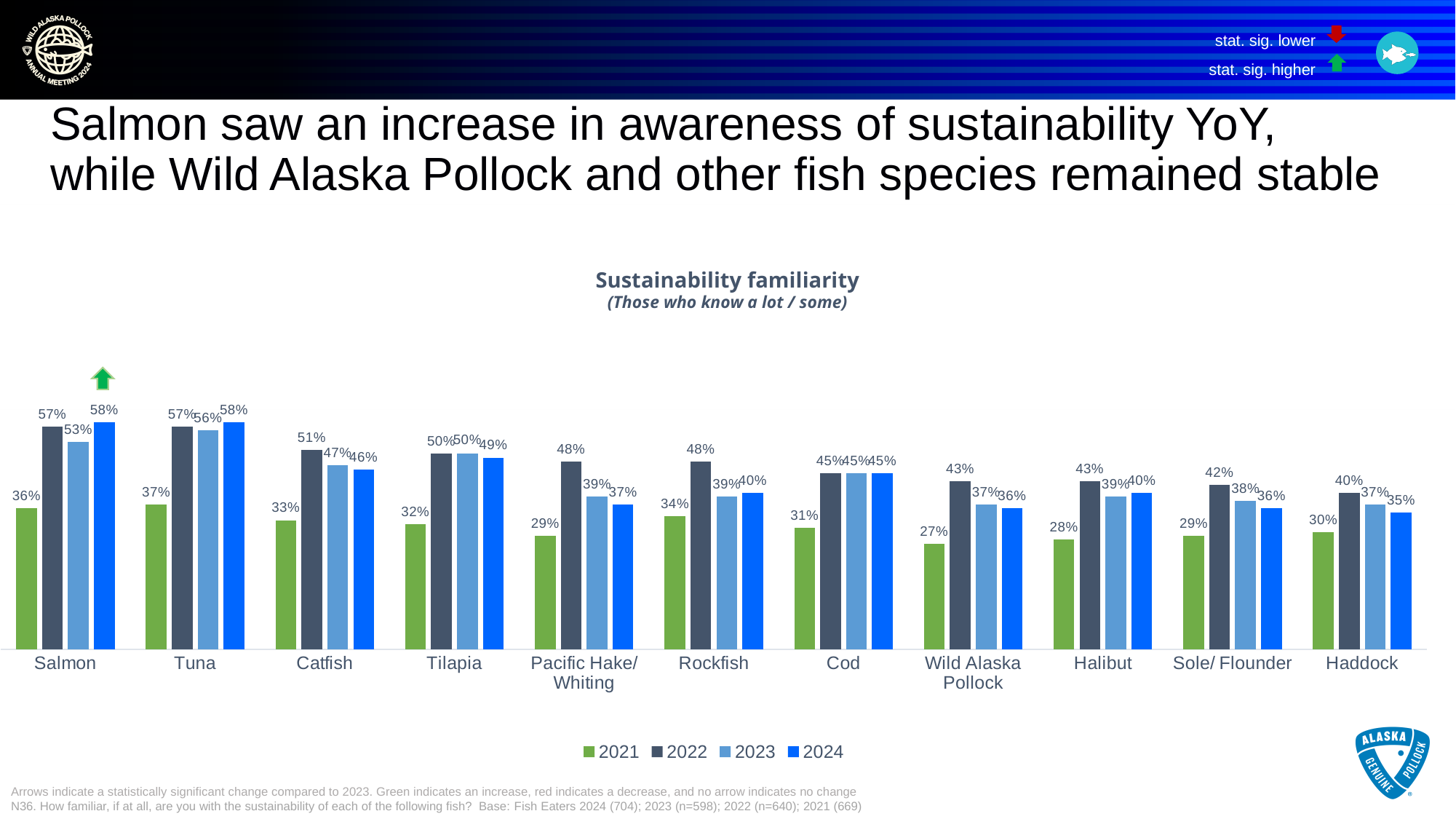
What is the 2021 value for Wild Alaska Pollock? 27% Which fish category has a green arrow above its bars? Salmon Which fish has the lowest 2022 value? Haddock Which fish has the highest 2023 value? Tuna How many series does the legend list? 4 What is the difference between the 2024 and 2021 values for Salmon? 22 percentage points What kind of chart is shown on the slide? Bar chart What is the 2023 value for Pacific Hake/ Whiting? 39% How many fish categories are shown on the x axis? 11 Which is larger, the 2022 value for Rockfish or the 2022 value for Cod? Rockfish Do the values for Wild Alaska Pollock rise or fall from 2022 to 2024? Fall What is the 2024 value for Salmon? 58%